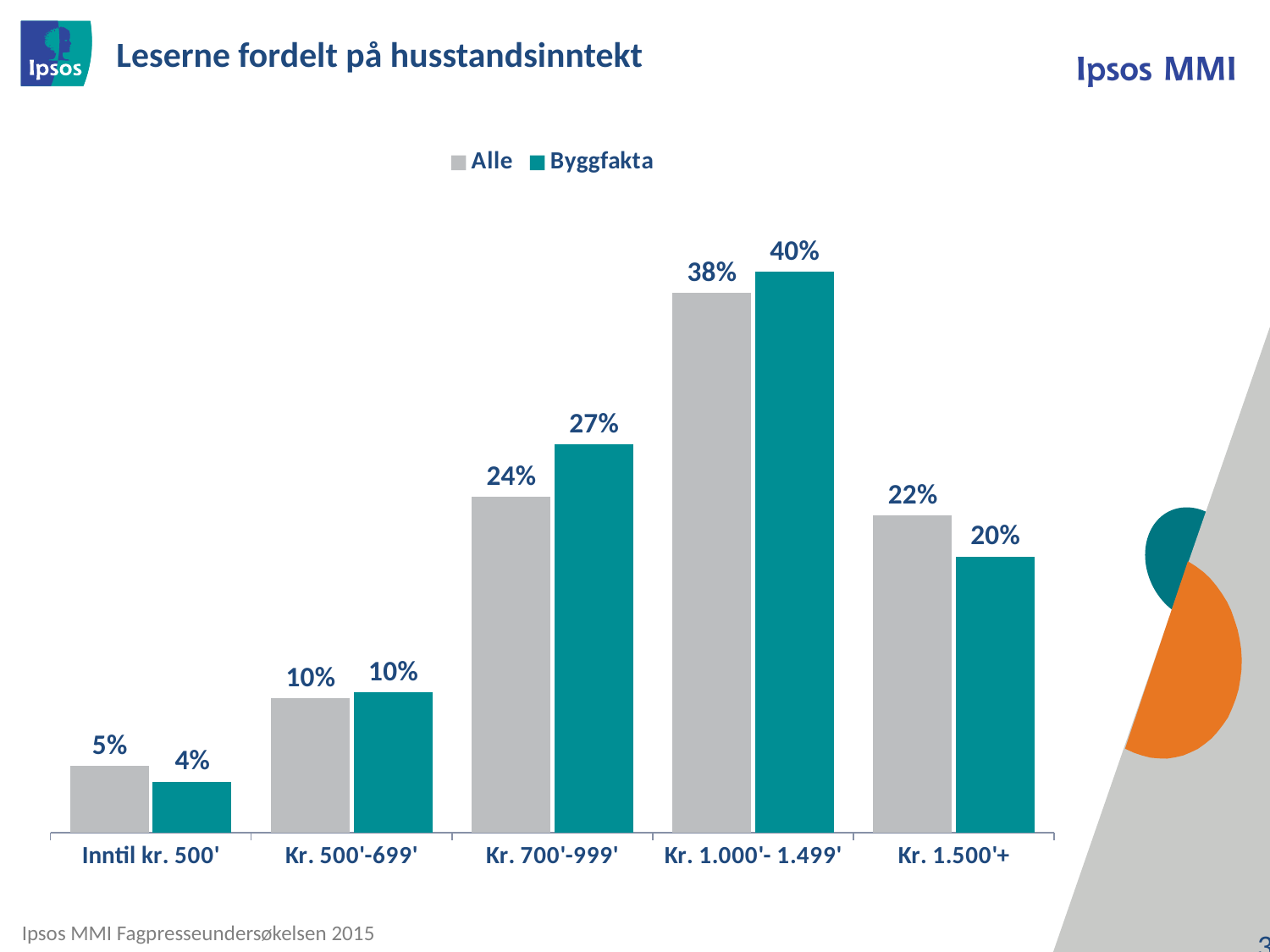
What is the value for Byggfakta in the Inntil kr. 500' category? 4% How many income categories are shown on the x axis? 5 Which income category has the highest value for Alle? Kr. 1.000'- 1.499' What is the value for Alle in the Kr. 500'-699' category? 10% What is the value for Byggfakta in the Kr. 1.000'- 1.499' category? 40% How many series does the legend list? 2 What is the difference between Byggfakta and Alle in the Kr. 700'-999' category? 3% What is the title of the chart? Leserne fordelt på husstandsinntekt What is the value for Alle in the Kr. 700'-999' category? 24% What kind of chart is shown on the slide? Bar chart In the Kr. 1.500'+ category, which series has the larger value, Alle or Byggfakta? Alle Which income category has the lowest value for Byggfakta? Inntil kr. 500'